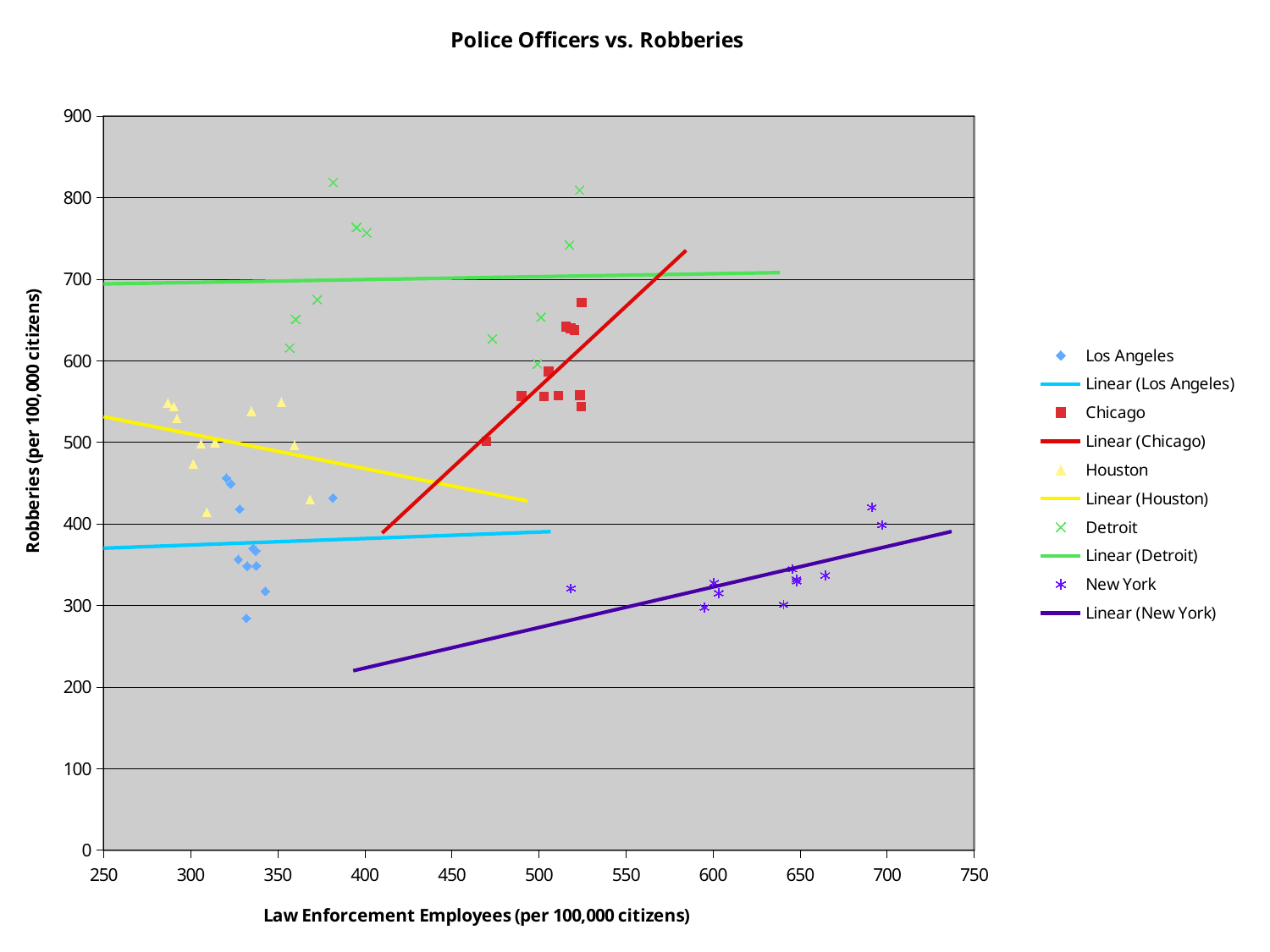
Does the Linear (Houston) trend line rise or fall as law enforcement employees increase? fall Which city has higher robbery values, Detroit or New York? Detroit What kind of chart is shown on the slide? Scatter chart What is the label of the x axis? Law Enforcement Employees (per 100,000 citizens) How many entries does the chart's legend list? 10 Are the robbery values for New York greater or less than 450? less Which city's data points have the highest robbery values? Detroit Which city's data points have the highest law enforcement employee values? New York What is the title of the chart? Police Officers vs. Robberies Does the Linear (Chicago) trend line rise or fall as law enforcement employees increase? rise Are the robbery values for Los Angeles greater or less than 500? less